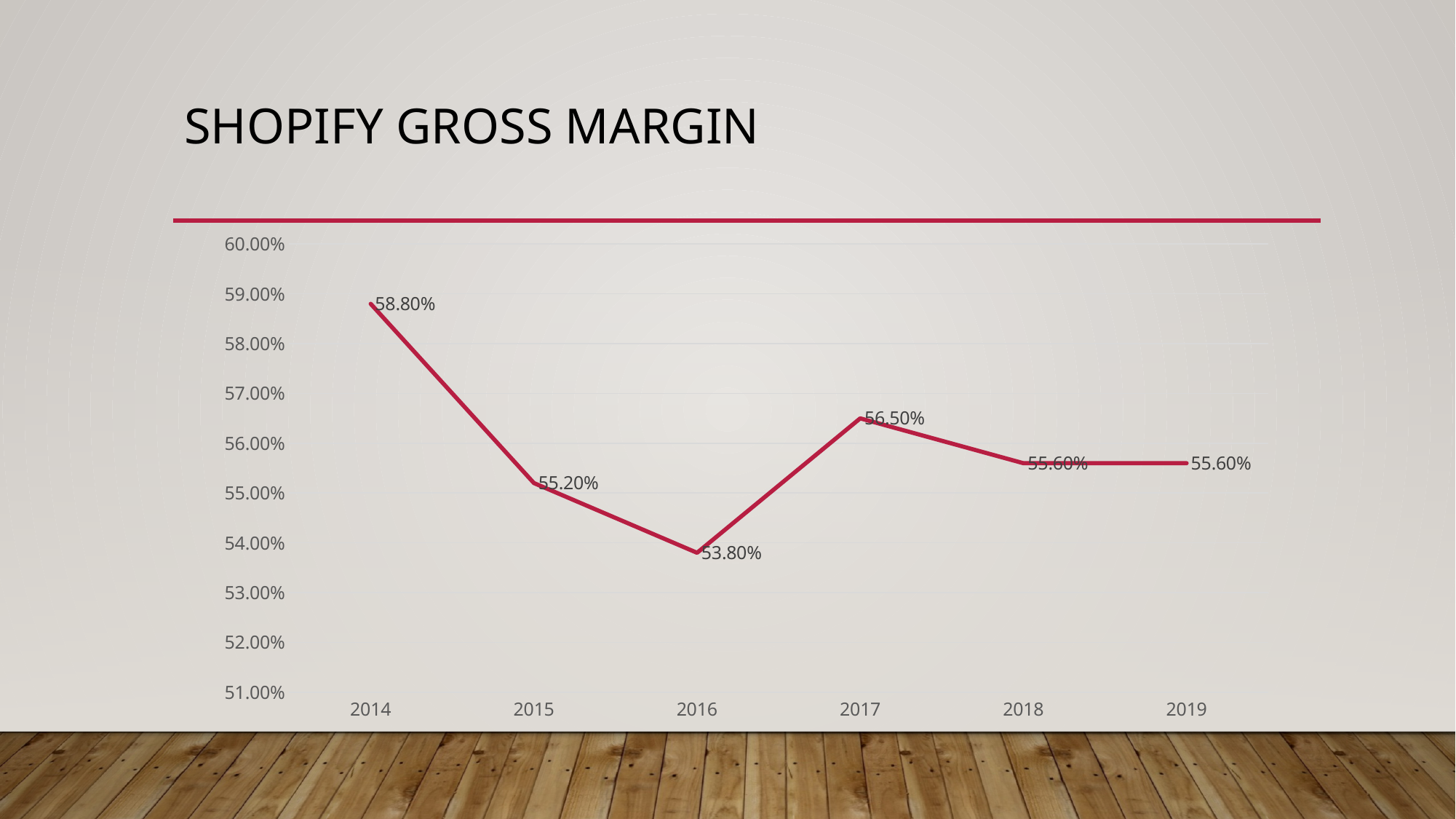
What is the difference between the gross margin in 2014 and in 2016? 5.00% Which year has the lowest gross margin? 2016 What is the gross margin for 2017? 56.50% What is the gross margin for 2014? 58.80% How many years are plotted on the chart? 6 What is the gross margin for 2016? 53.80% What kind of chart is shown on the slide? Line chart Which year has a higher gross margin, 2015 or 2017? 2017 What is the difference between the gross margin in 2017 and in 2018? 0.90% What is the gross margin for 2019? 55.60% What is the title of the slide? Shopify Gross Margin Which year has the highest gross margin? 2014